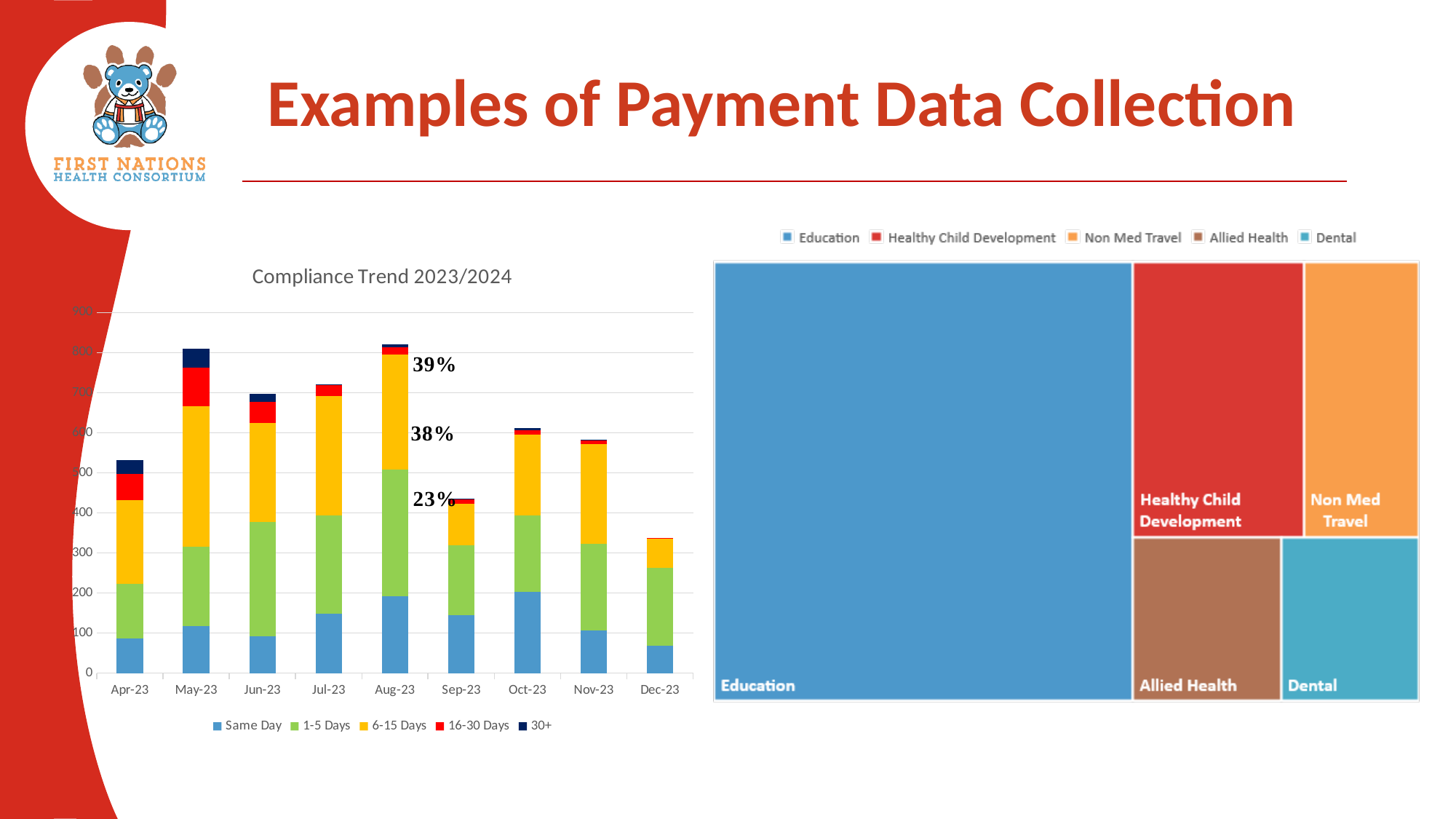
In the Compliance Trend 2023/2024 chart, is the total for Dec-23 greater or less than 400? less In the Compliance Trend 2023/2024 chart, is the total for May-23 greater or less than 700? greater How many months are shown on the x axis of the Compliance Trend 2023/2024 chart? 9 In the Compliance Trend 2023/2024 chart, which series is shown in yellow? 6-15 Days What type of chart is the Compliance Trend 2023/2024 chart on the left? Stacked bar chart How many series does the legend of the Compliance Trend 2023/2024 chart list? 5 In the Compliance Trend 2023/2024 chart, which total bar is larger, Jul-23 or Sep-23? Jul-23 In the Compliance Trend 2023/2024 chart, which month has the lowest total bar? Dec-23 What type of chart is shown on the right side of the slide? Treemap In the treemap on the right, which category occupies the largest area? Education How many categories does the treemap on the right show? 5 In the Compliance Trend 2023/2024 chart, is the total for Sep-23 greater or less than 500? less